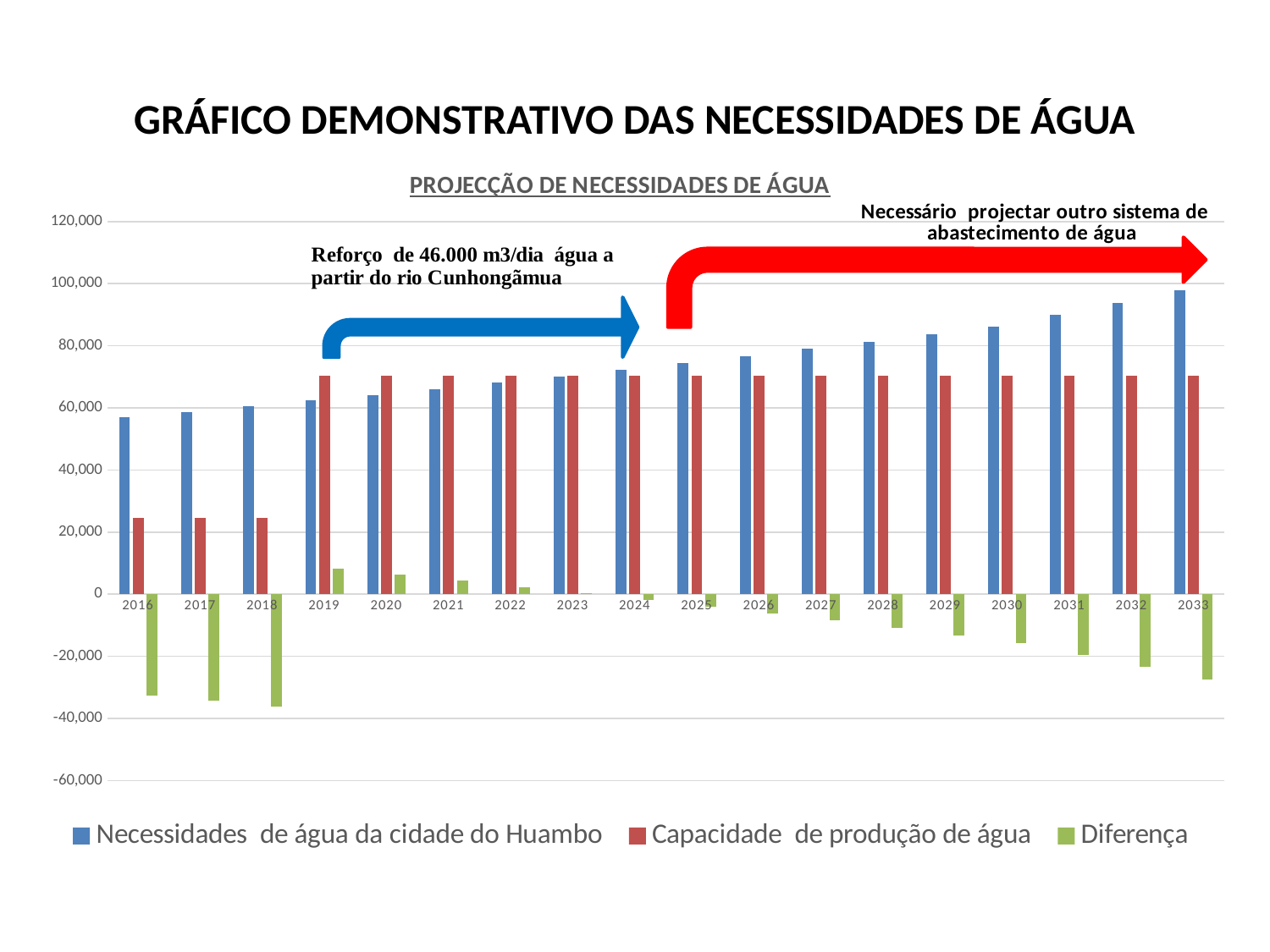
Is the value for 'Diferença' in 2018 greater or less than -20,000? less Do the values for 'Necessidades de água da cidade do Huambo' rise or fall from 2016 to 2033? Rise How many series does the chart legend list? 3 What is the title of the chart? PROJECÇÃO DE NECESSIDADES DE ÁGUA Which series is shown in green in the chart? Diferença In which year is 'Necessidades de água da cidade do Huambo' lowest? 2016 In 2019, which is larger: 'Necessidades de água da cidade do Huambo' or 'Capacidade de produção de água'? Capacidade de produção de água Is the value for 'Necessidades de água da cidade do Huambo' in 2033 greater or less than 100,000? less In which year is 'Necessidades de água da cidade do Huambo' highest? 2033 How many years are shown on the x axis of the chart? 18 What kind of chart is shown on the slide? Bar chart Is the value for 'Capacidade de produção de água' in 2016 greater or less than 20,000? greater